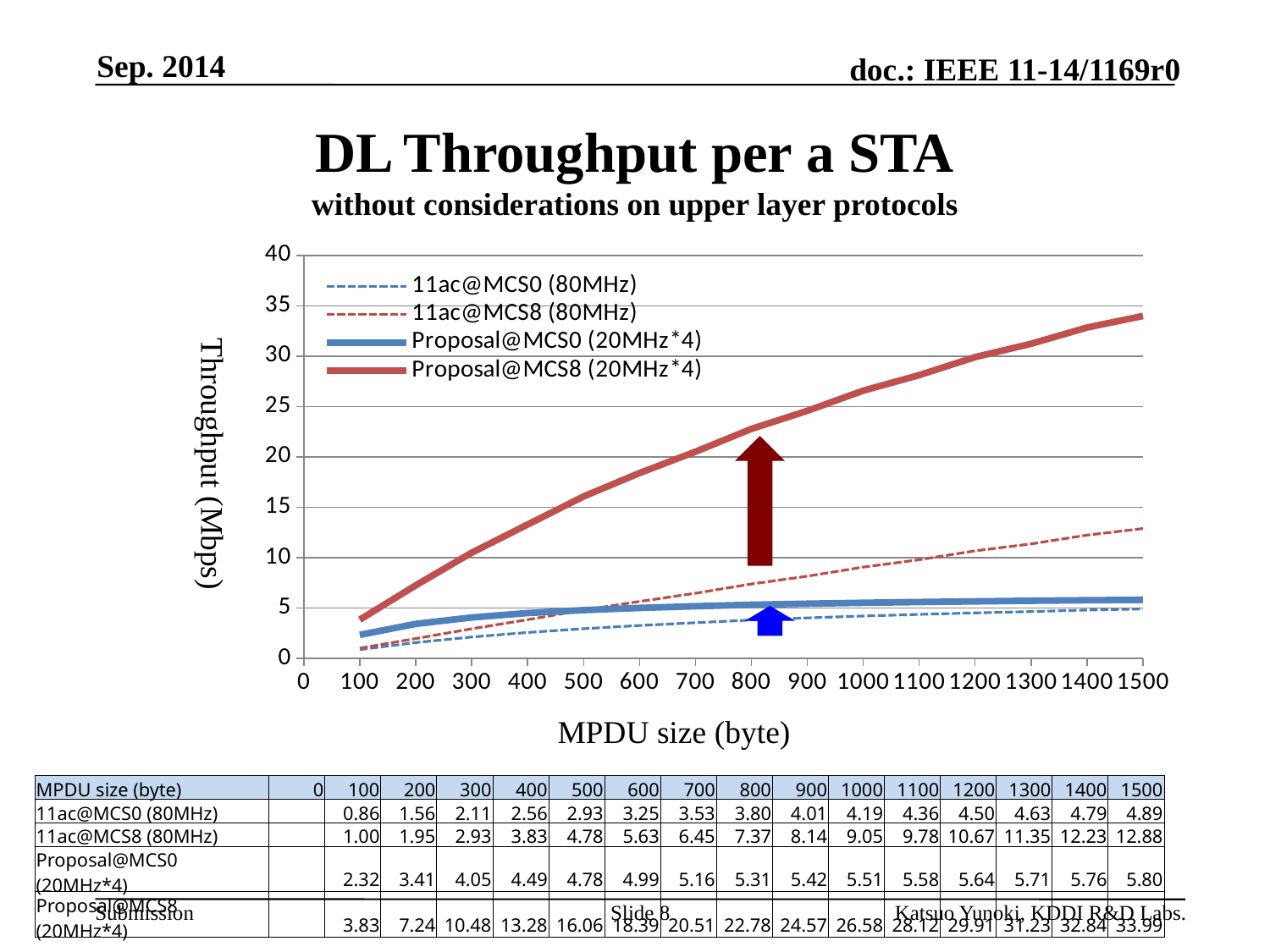
How many series does the chart legend list? 4 At an MPDU size of 400 bytes, which has the higher throughput: 11ac@MCS8 (80MHz) or Proposal@MCS0 (20MHz*4)? Proposal@MCS0 (20MHz*4) At an MPDU size of 1500 bytes, what is the difference in throughput between Proposal@MCS0 (20MHz*4) and 11ac@MCS0 (80MHz)? 0.91 Is the throughput for Proposal@MCS8 (20MHz*4) at an MPDU size of 1000 bytes greater or less than 25? greater What is the throughput for Proposal@MCS8 (20MHz*4) at an MPDU size of 500 bytes? 16.06 Does the throughput for Proposal@MCS8 (20MHz*4) rise or fall as MPDU size increases? rise Which series has the lowest throughput at an MPDU size of 100 bytes? 11ac@MCS0 (80MHz) What is the throughput for 11ac@MCS0 (80MHz) at an MPDU size of 1500 bytes? 4.89 What is the throughput for 11ac@MCS8 (80MHz) at an MPDU size of 1000 bytes? 9.05 Which series has the highest throughput at an MPDU size of 1500 bytes? Proposal@MCS8 (20MHz*4) What kind of chart is shown on the slide? line chart What is the label of the vertical axis of the chart? Throughput (Mbps)